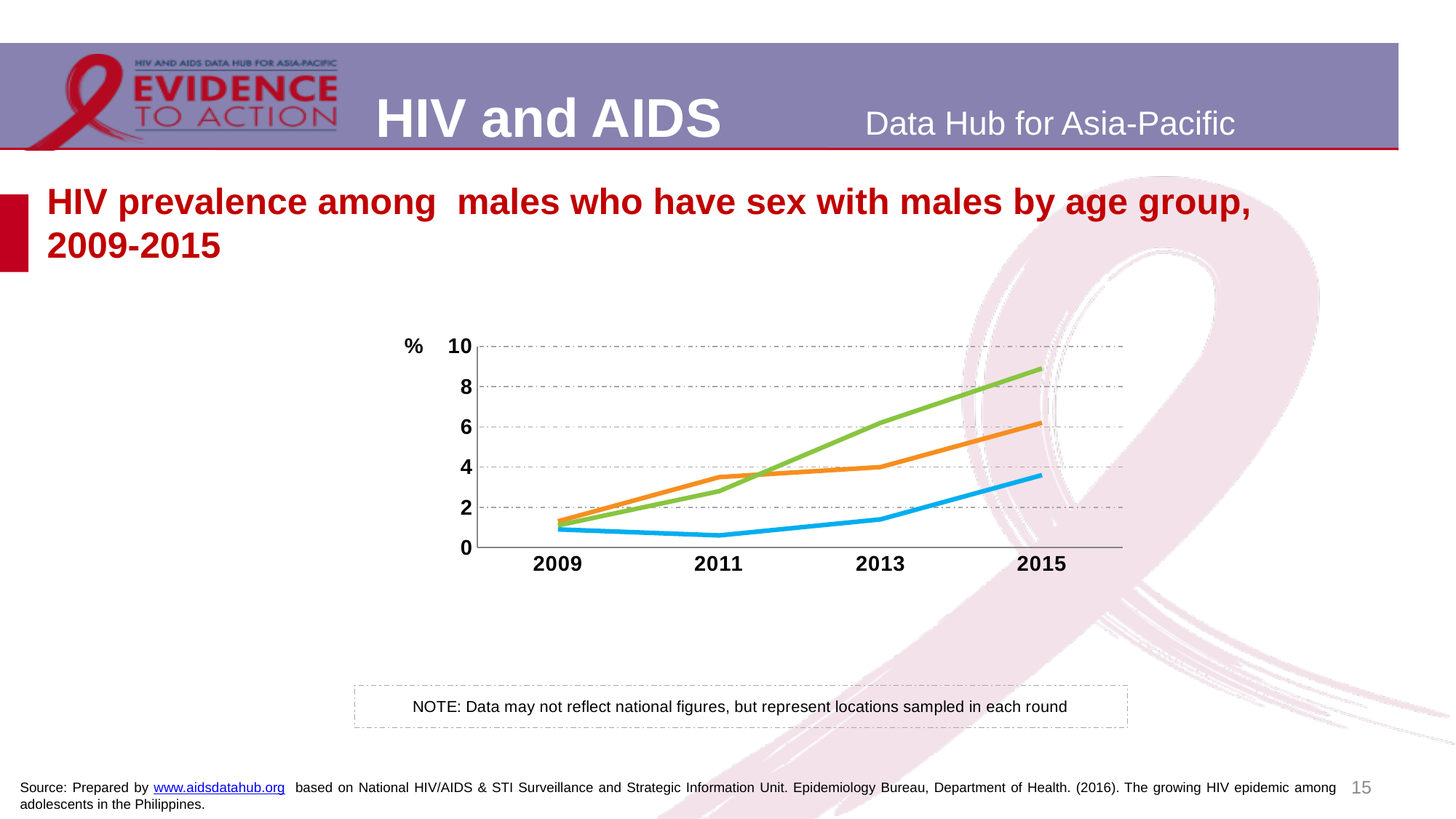
Is the value of the green line in 2015 greater or less than 8? greater In 2015, which line is higher, the green line or the orange line? green line Which line has the lowest value in 2015? blue line What kind of chart is shown on the slide? line chart Does the green line rise or fall from 2009 to 2015? rise What is the title of the chart on the slide? HIV prevalence among males who have sex with males by age group, 2009-2015 Is the value of the orange line in 2015 greater or less than 4? greater How many years are plotted along the x axis of the chart? 4 What unit is shown on the y axis of the chart? % How many lines are plotted on the chart? 3 Is the value of the blue line in 2011 greater or less than 2? less